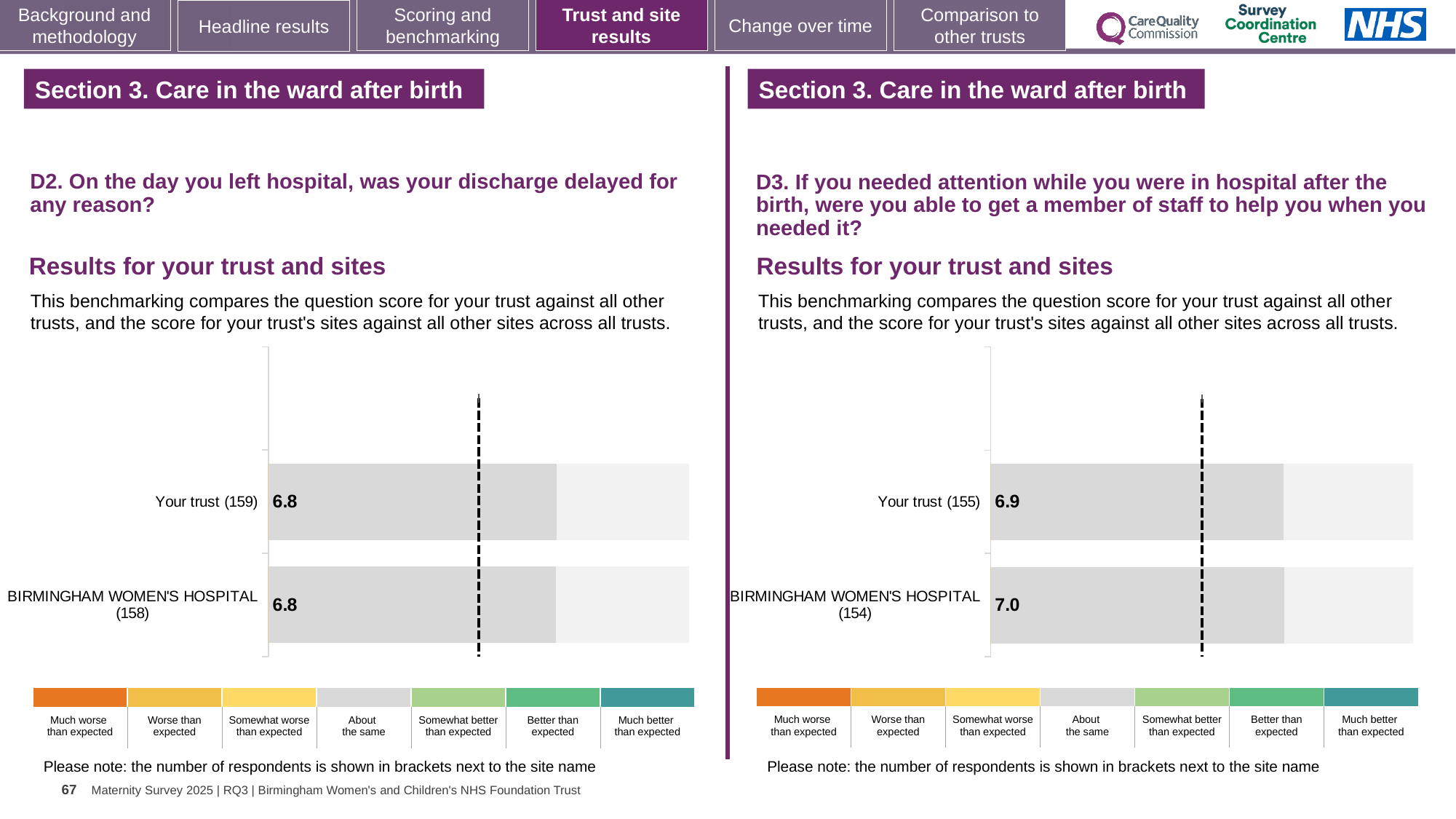
How many bars are plotted in the left chart (D2)? 2 In the right chart (D3, able to get a member of staff to help), what is the score for BIRMINGHAM WOMEN'S HOSPITAL (154)? 7.0 In the left chart (D2, discharge delayed), what is the score for BIRMINGHAM WOMEN'S HOSPITAL (158)? 6.8 In the right chart (D3, able to get a member of staff to help), what is the score for Your trust (155)? 6.9 What type of chart is used for the D2 results on the left? Bar chart In the right chart (D3), which has the higher score: Your trust or BIRMINGHAM WOMEN'S HOSPITAL? BIRMINGHAM WOMEN'S HOSPITAL In the right chart (D3), how many respondents are shown in brackets for BIRMINGHAM WOMEN'S HOSPITAL? 154 How many benchmark categories does the colour legend below the left chart (D2) list? 7 In the left chart (D2), is the score for Your trust higher than, lower than, or equal to the score for BIRMINGHAM WOMEN'S HOSPITAL? equal In the left chart (D2, discharge delayed), what is the score for Your trust (159)? 6.8 In the right chart (D3), what is the difference between the BIRMINGHAM WOMEN'S HOSPITAL score and the Your trust score? 0.1 How many bars are plotted in the right chart (D3)? 2